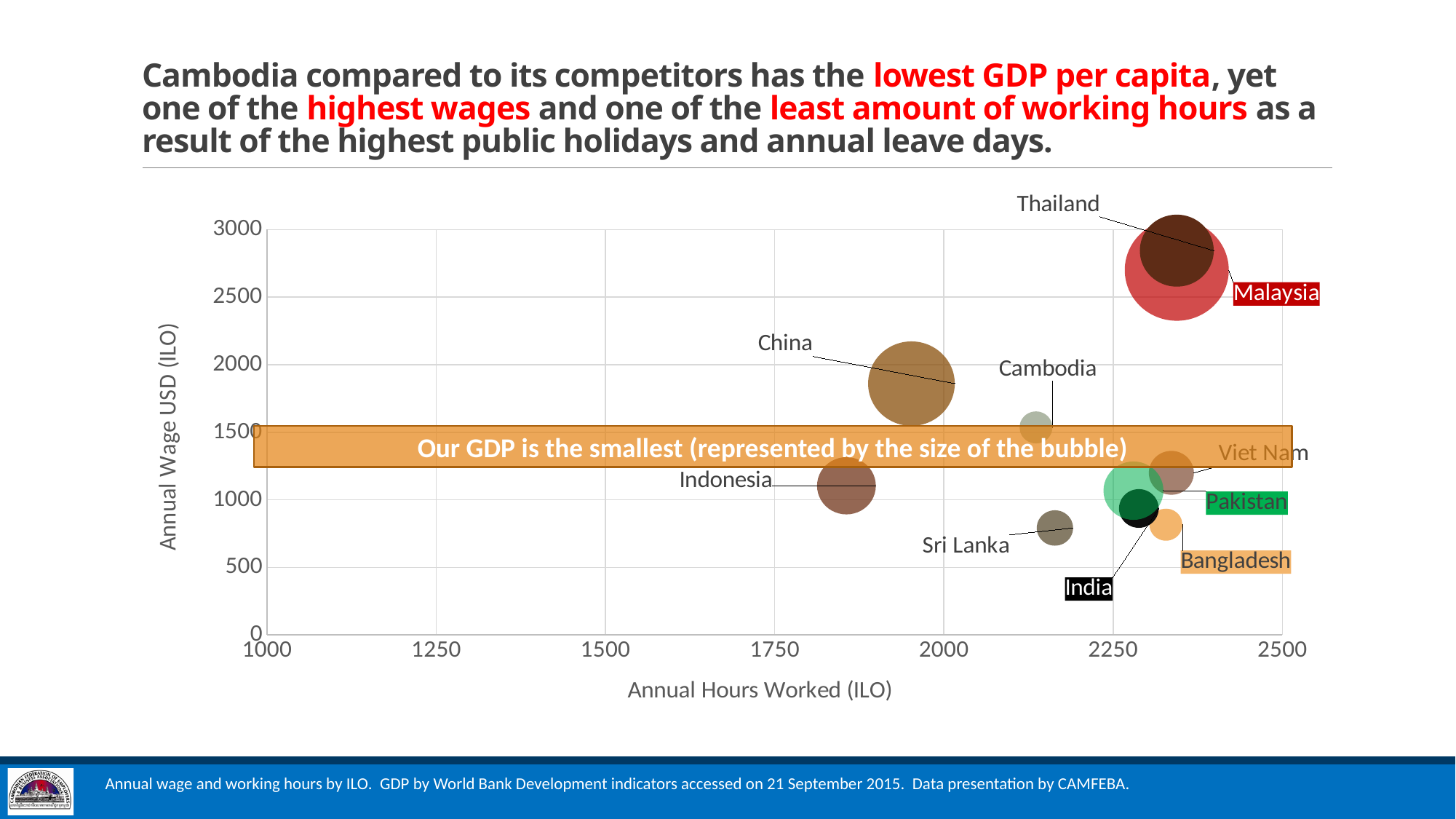
How many countries are plotted as bubbles on the chart? 10 Which country has the lowest annual hours worked on the chart? Indonesia Which country has the highest annual wage on the chart? Thailand Is the annual wage for Sri Lanka greater or less than 1000? less Are the annual hours worked for Malaysia greater or less than 2250? greater What kind of chart is shown on the slide? Bubble chart Is the annual wage for Thailand greater or less than 2500? greater Which has the higher annual wage, China or Indonesia? China Which country is represented by the smallest bubble? Cambodia What does the size of each bubble represent, according to the slide? GDP